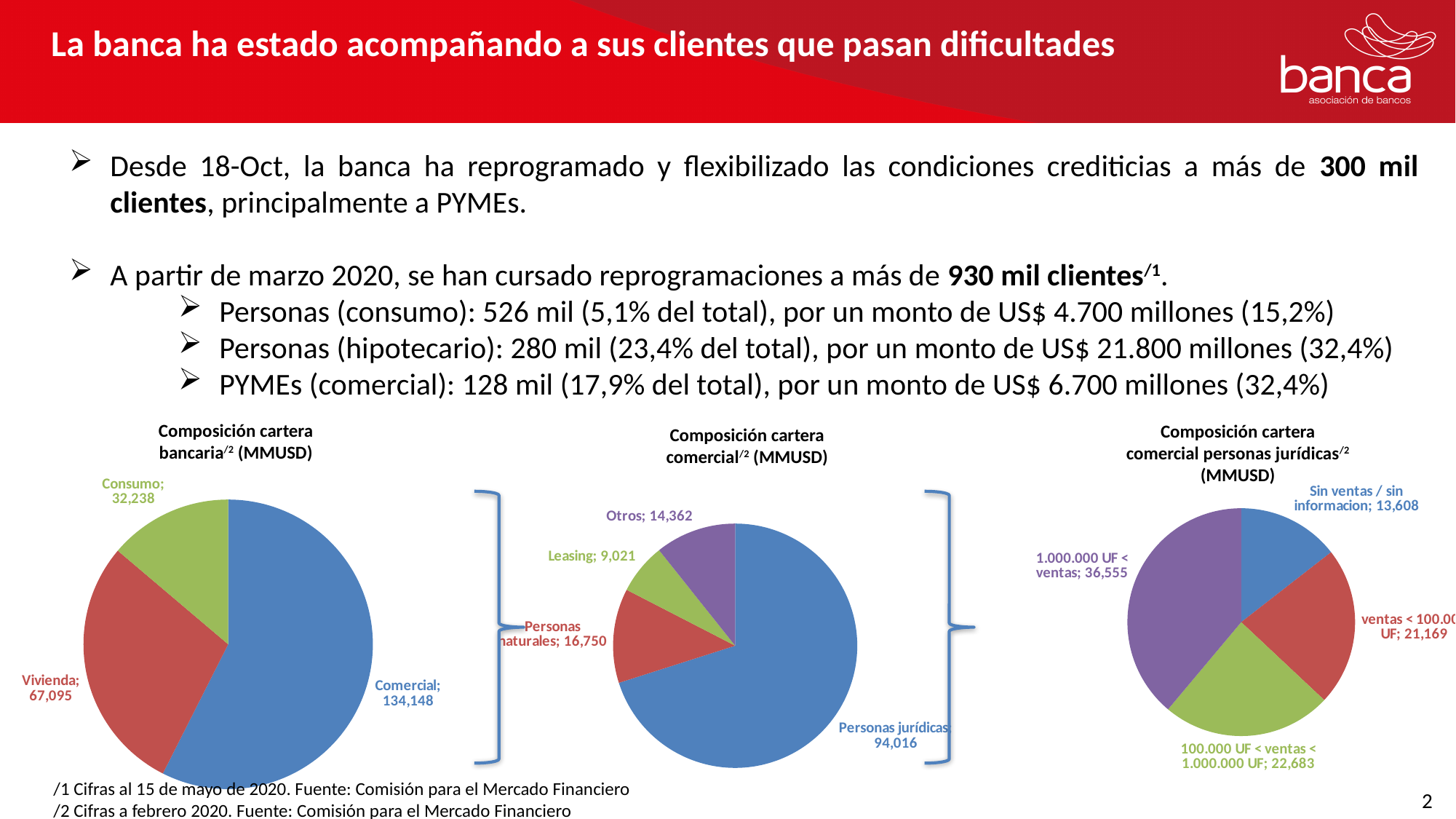
In the 'Composición cartera comercial (MMUSD)' pie chart, which category is the largest? Personas jurídicas In the 'Composición cartera bancaria (MMUSD)' pie chart, what is the difference between Comercial and Vivienda? 67,053 In the 'Composición cartera bancaria (MMUSD)' pie chart, which category is the smallest? Consumo In the 'Composición cartera comercial (MMUSD)' pie chart, which is larger, Otros or Personas naturales? Personas naturales In the 'Composición cartera comercial (MMUSD)' pie chart, what is the value for Leasing? 9,021 In the 'Composición cartera comercial personas jurídicas (MMUSD)' pie chart, which category is the smallest? Sin ventas / sin informacion In the 'Composición cartera comercial personas jurídicas (MMUSD)' pie chart, what is the value for '1.000.000 UF < ventas'? 36,555 In the 'Composición cartera bancaria (MMUSD)' pie chart, what is the value for Vivienda? 67,095 In the 'Composición cartera comercial (MMUSD)' pie chart, what is the difference between Personas jurídicas and Personas naturales? 77,266 In the 'Composición cartera bancaria (MMUSD)' pie chart, how many categories are shown? 3 In the 'Composición cartera bancaria (MMUSD)' pie chart, what is the value for Comercial? 134,148 What type of chart is used for the three charts at the bottom of the slide? Pie chart